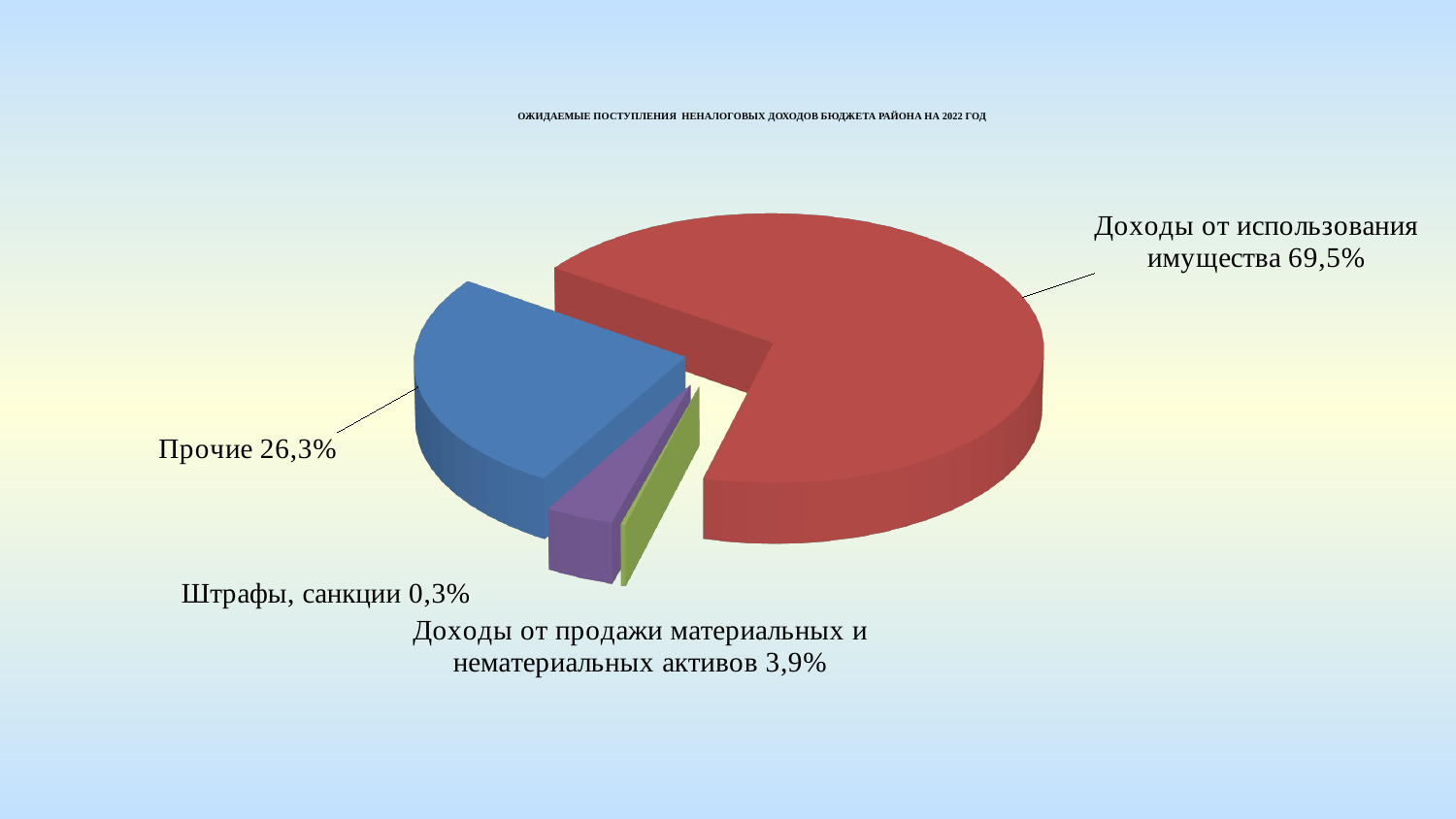
What colour is the slice for "Прочие"? Blue What share of the pie is labelled "Доходы от продажи материальных и нематериальных активов"? 3,9% Which category has the largest share of the pie? Доходы от использования имущества Which category has the smallest share of the pie? Штрафы, санкции What share of the pie is labelled "Доходы от использования имущества"? 69,5% What is the difference in percentage points between "Доходы от использования имущества" and "Прочие"? 43,2 What share of the pie is labelled "Штрафы, санкции"? 0,3% What colour is the slice for "Доходы от использования имущества"? Red How many slices does the pie chart have? 4 What share of the pie is labelled "Прочие"? 26,3% Which is larger: the share for "Прочие" or the share for "Доходы от продажи материальных и нематериальных активов"? Прочие What kind of chart is shown on the slide? Pie chart